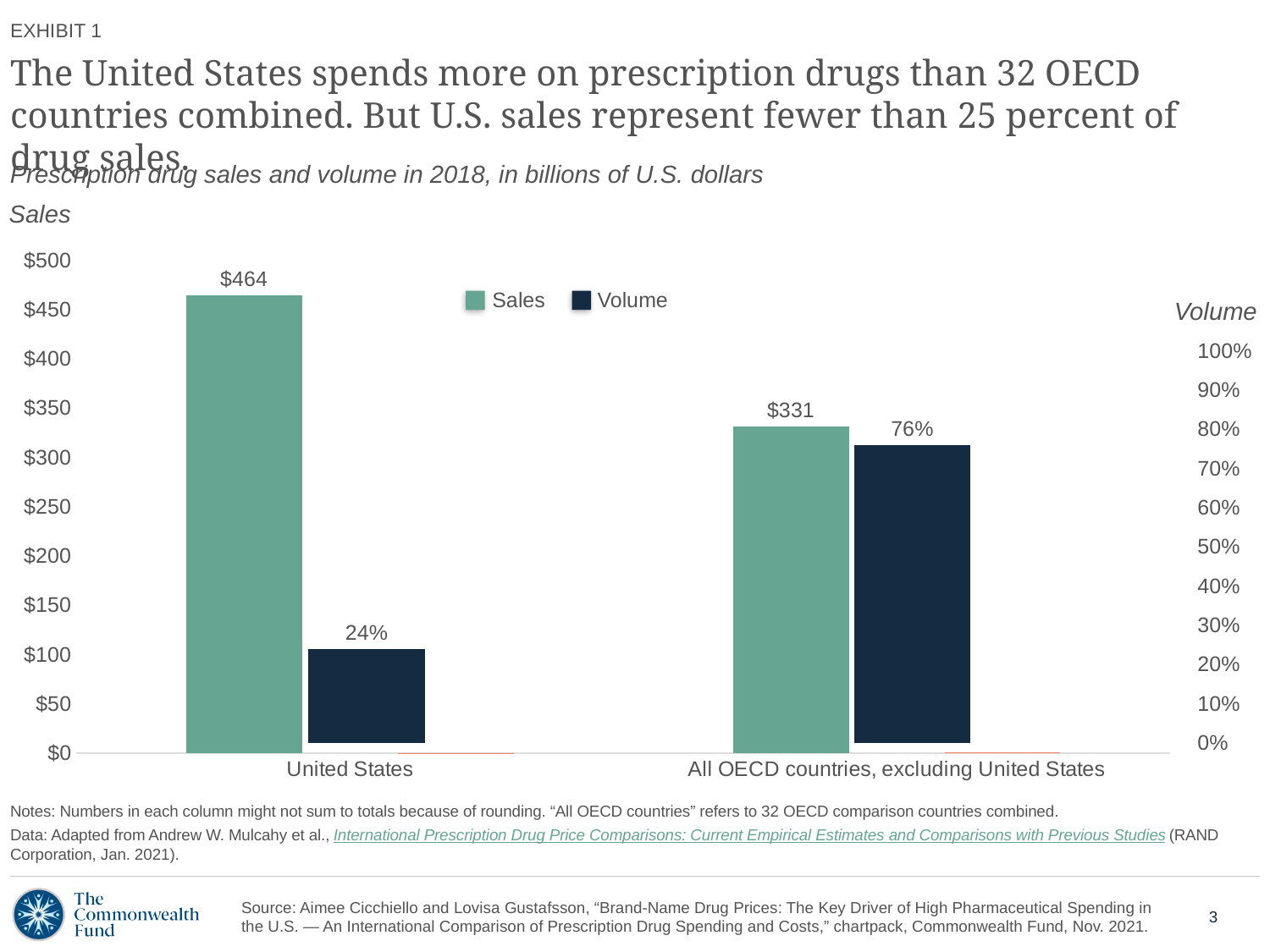
What is the Volume value for the United States? 24% What is the difference in Sales between the United States and All OECD countries, excluding United States? $133 Which category has the lower Volume value? United States What is the Volume value for All OECD countries, excluding United States? 76% What is the Sales value for All OECD countries, excluding United States? $331 What kind of chart is shown on the slide? bar chart Which category has the higher Sales value? United States How many categories are shown on the x axis? 2 How many series does the legend list? 2 What is the difference in Volume between All OECD countries, excluding United States and the United States? 52% What is the Sales value for the United States? $464 Is the Volume for the United States larger or smaller than the Volume for All OECD countries, excluding United States? smaller